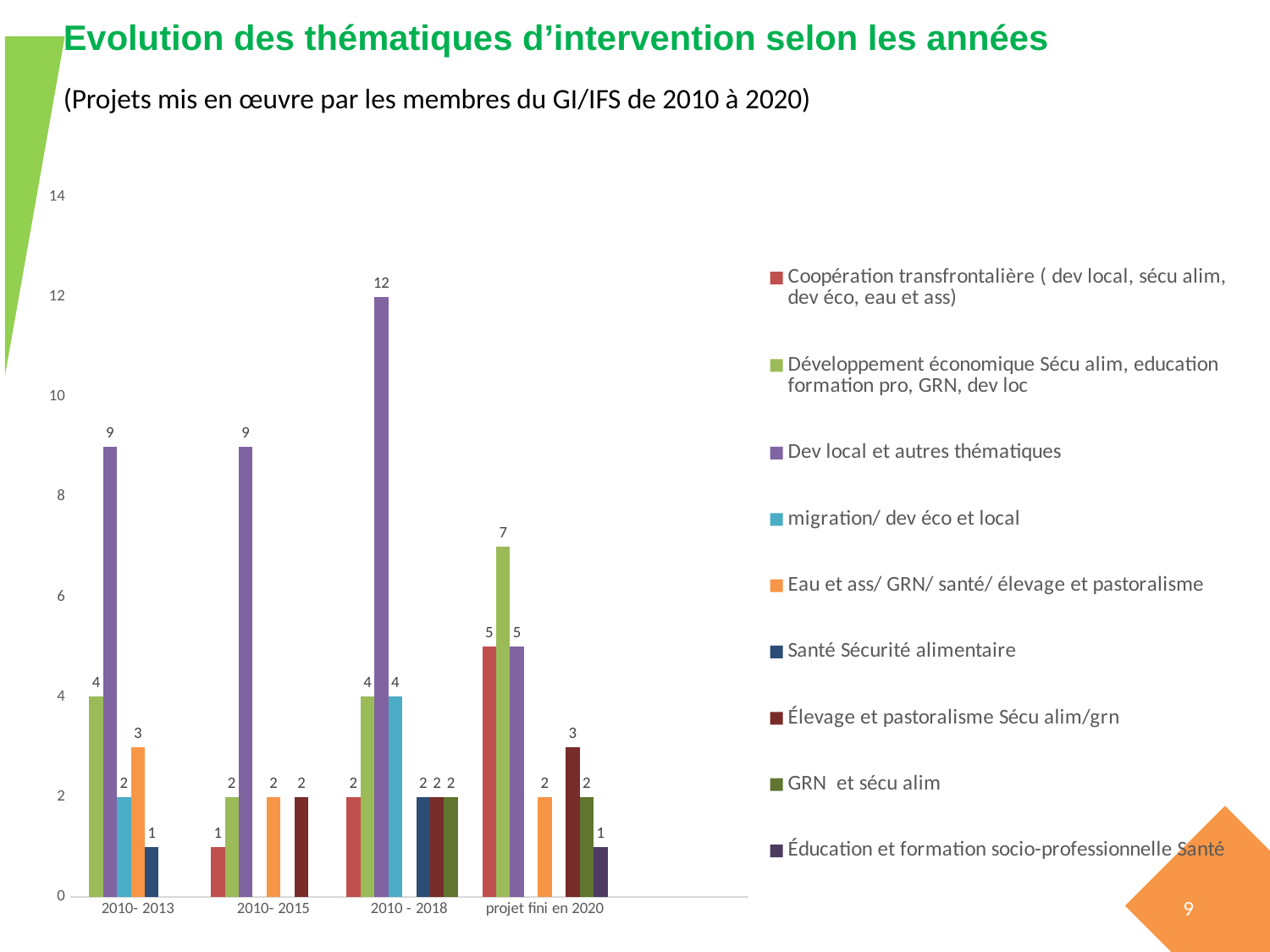
How many series does the legend list? 9 What is the value for 'Élevage et pastoralisme Sécu alim/grn' in 'projet fini en 2020'? 3 What is the title of the chart? Evolution des thématiques d'intervention selon les années What is the value for 'Eau et ass/ GRN/ santé/ élevage et pastoralisme' in 2010- 2013? 3 What is the value for 'Développement économique Sécu alim, education formation pro, GRN, dev loc' in 'projet fini en 2020'? 7 In 'projet fini en 2020', which is larger: 'Développement économique Sécu alim, education formation pro, GRN, dev loc' or 'Coopération transfrontalière'? Développement économique Sécu alim, education formation pro, GRN, dev loc Does the value for 'Coopération transfrontalière' rise or fall from 2010- 2015 to 'projet fini en 2020'? Rise How many period categories are shown on the x axis? 4 Which series has the highest value in the whole chart? Dev local et autres thématiques What is the value for 'Dev local et autres thématiques' in 2010 - 2018? 12 What kind of chart is shown on the slide? Bar chart What is the difference between the 'Dev local et autres thématiques' values for 2010 - 2018 and 2010- 2015? 3